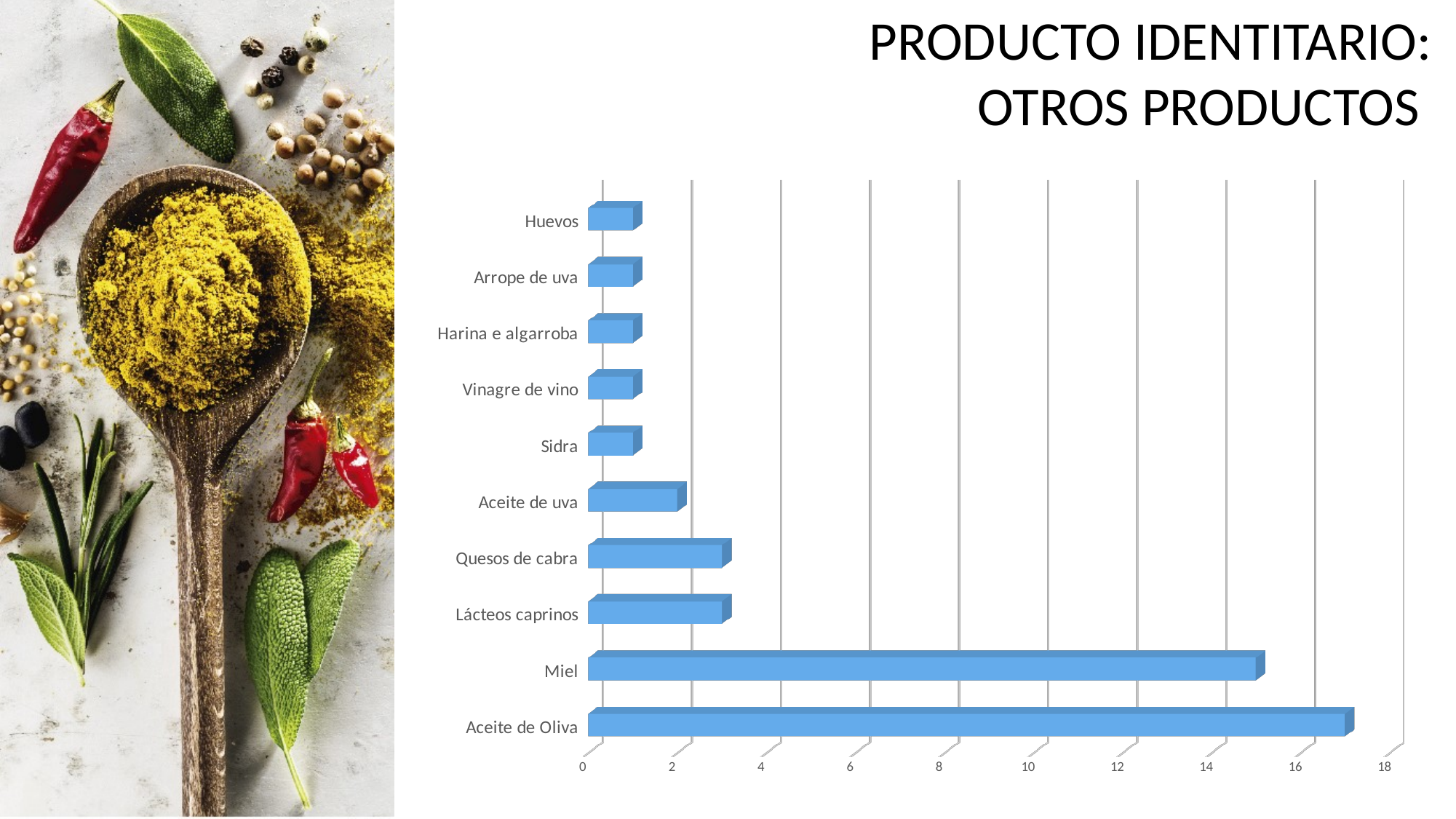
Which has the larger value, Aceite de Oliva or Miel? Aceite de Oliva What is the title of the slide containing the chart? PRODUCTO IDENTITARIO: OTROS PRODUCTOS What is the highest value shown on the horizontal axis of the chart? 18 Is the value for Huevos greater or less than 2? less Is the value for Aceite de Oliva greater or less than 16? greater How many product categories are plotted in the chart? 10 What kind of chart is shown on the slide? bar chart Is the value for Quesos de cabra greater or less than 4? less Which product has the highest value in the chart? Aceite de Oliva Which has the larger value, Miel or Quesos de cabra? Miel Which has the larger value, Aceite de uva or Huevos? Aceite de uva